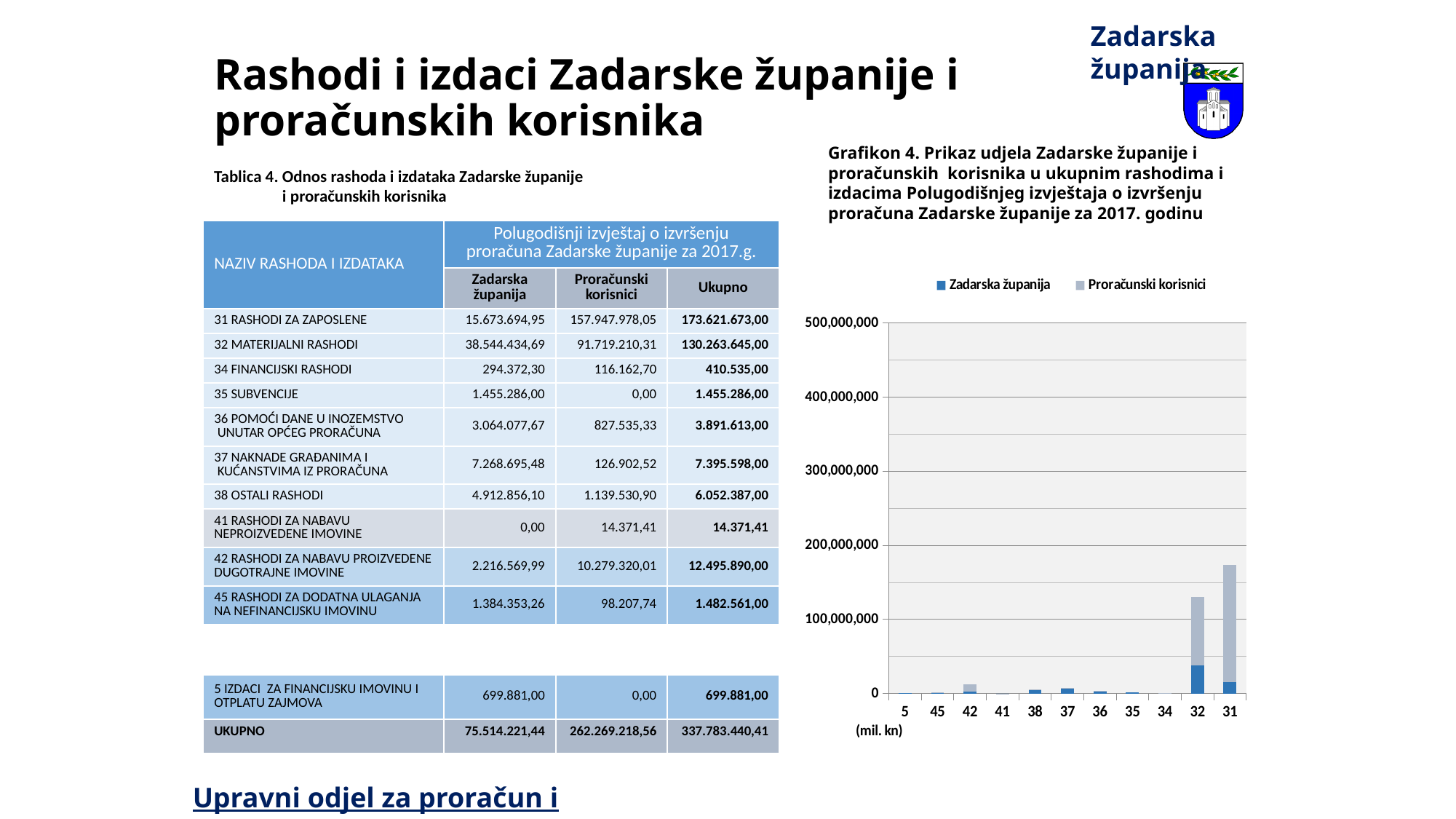
Which bar is taller in the chart, category 31 or category 32? 31 How many series does the chart's legend list? 2 What kind of chart is shown on the right side of the slide? bar chart What are the two series named in the chart's legend? Zadarska županija and Proračunski korisnici Which bar is taller in the chart, category 32 or category 42? 32 Is the total bar for category 31 greater or less than 100,000,000? greater What is the highest value shown on the chart's y axis? 500,000,000 How many categories are shown on the x axis of the chart? 11 Is the total bar for category 42 greater or less than 100,000,000? less Is the total bar for category 31 greater or less than 200,000,000? less Which category has the tallest bar in the chart? 31